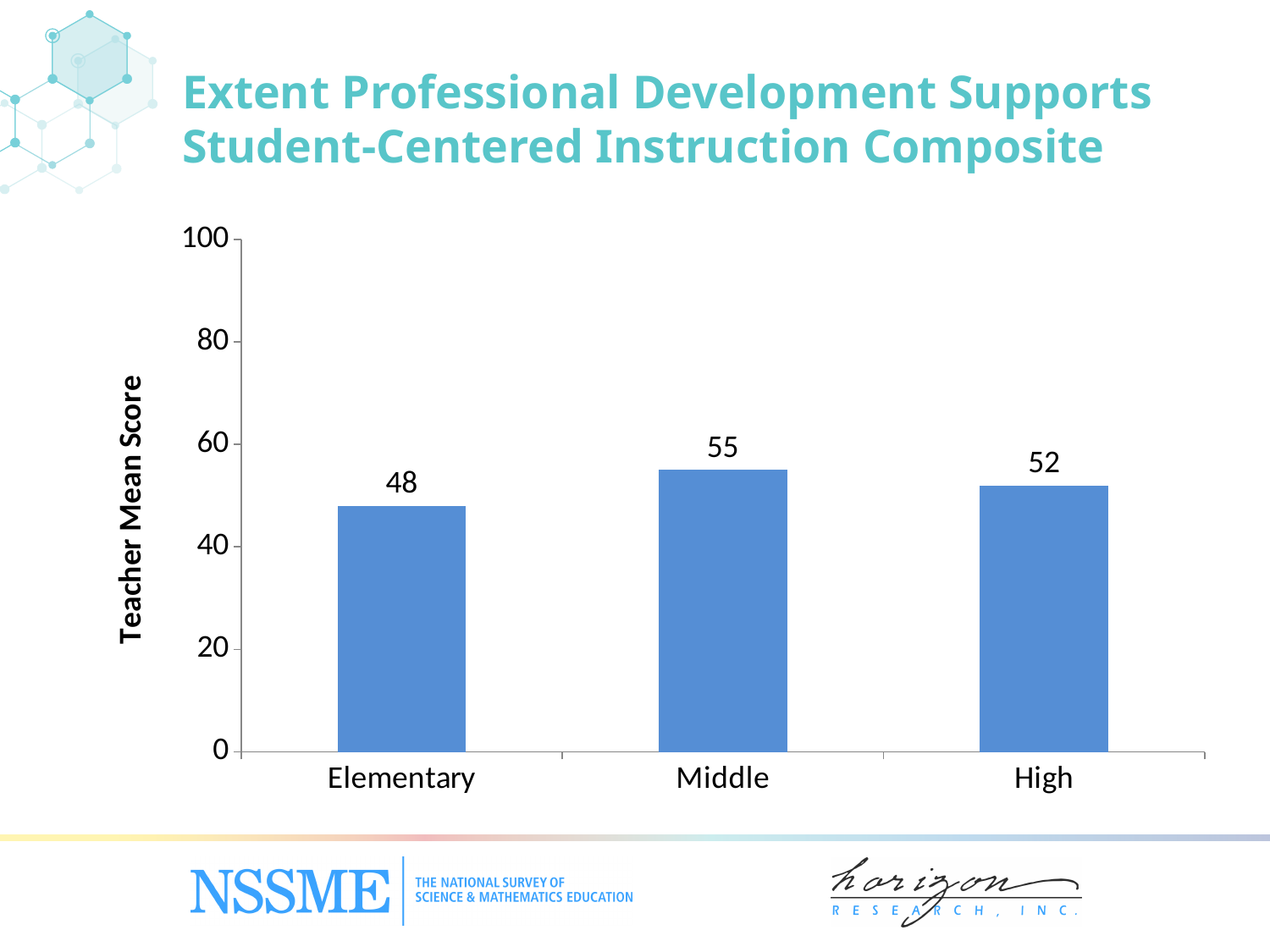
What is the teacher mean score for Elementary? 48 What is the teacher mean score for High? 52 What is the label of the vertical axis? Teacher Mean Score Is the value for Elementary greater or less than 60? less What kind of chart is shown on the slide? Bar chart Which grade level has the highest teacher mean score? Middle What is the difference between the teacher mean scores for Middle and High? 3 What is the difference between the teacher mean scores for Middle and Elementary? 7 How many grade-level categories are shown on the chart? 3 Which has a higher teacher mean score, High or Elementary? High What is the teacher mean score for Middle? 55 Which grade level has the lowest teacher mean score? Elementary